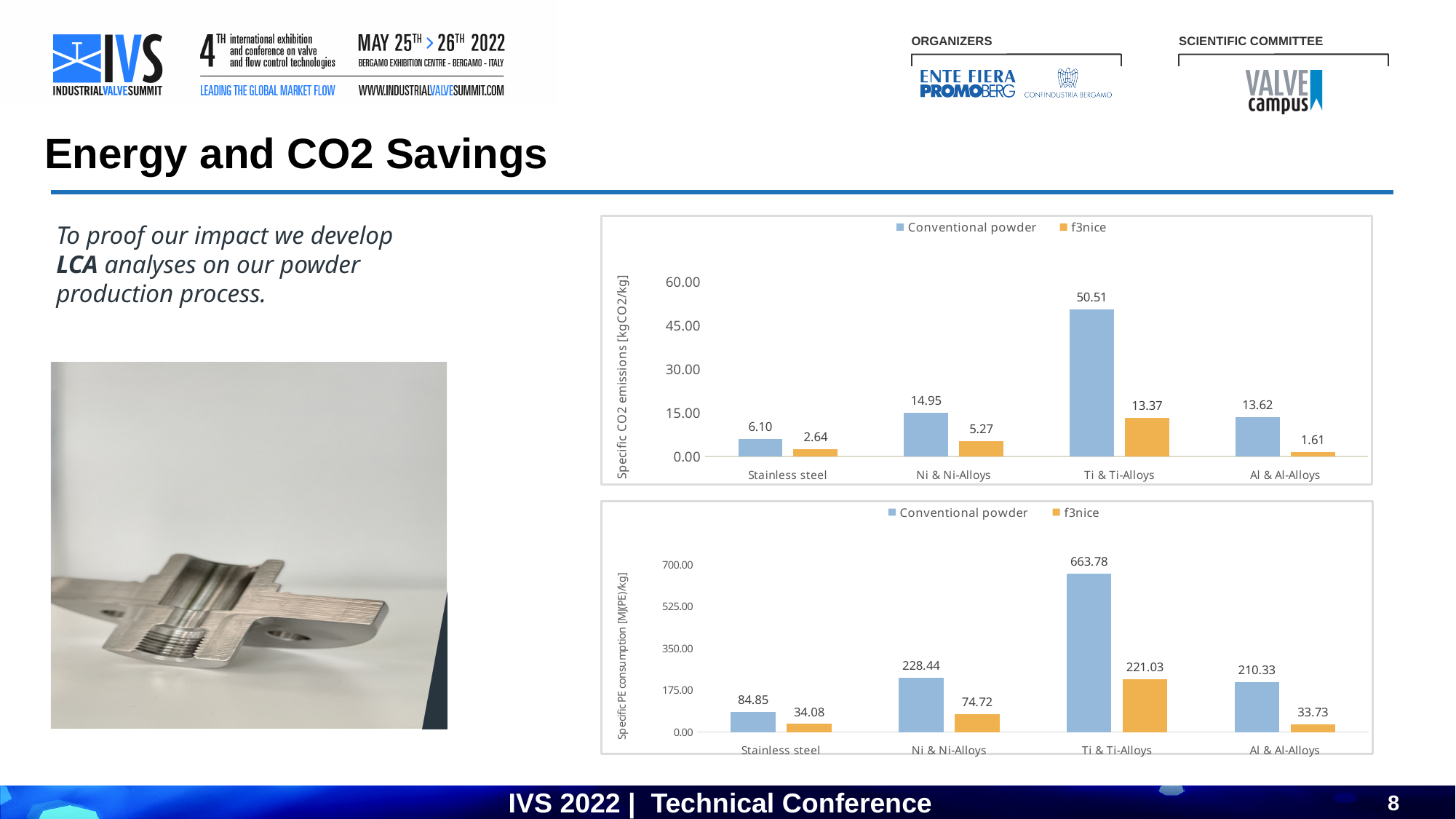
In the bottom chart (Specific PE consumption), what is the difference between the Conventional powder and f3nice values for Ti & Ti-Alloys? 442.75 How many categories are shown on the x axis of the top chart (Specific CO2 emissions)? 4 In the bottom chart (Specific PE consumption), what is the f3nice value for Stainless steel? 34.08 In the top chart (Specific CO2 emissions), what is the difference between the Conventional powder and f3nice values for Stainless steel? 3.46 How many series does the legend of the bottom chart (Specific PE consumption) list? 2 In the bottom chart (Specific PE consumption), what is the Conventional powder value for Ni & Ni-Alloys? 228.44 What type of chart is the top chart (Specific CO2 emissions)? Bar chart In the top chart (Specific CO2 emissions), what is the value for Conventional powder for Ti & Ti-Alloys? 50.51 In the top chart (Specific CO2 emissions), which category has the lowest f3nice value? Al & Al-Alloys In the top chart (Specific CO2 emissions), which category has the highest Conventional powder value? Ti & Ti-Alloys In the bottom chart (Specific PE consumption), which is larger: the f3nice value for Ti & Ti-Alloys or the Conventional powder value for Al & Al-Alloys? f3nice value for Ti & Ti-Alloys In the top chart (Specific CO2 emissions), what is the f3nice value for Al & Al-Alloys? 1.61